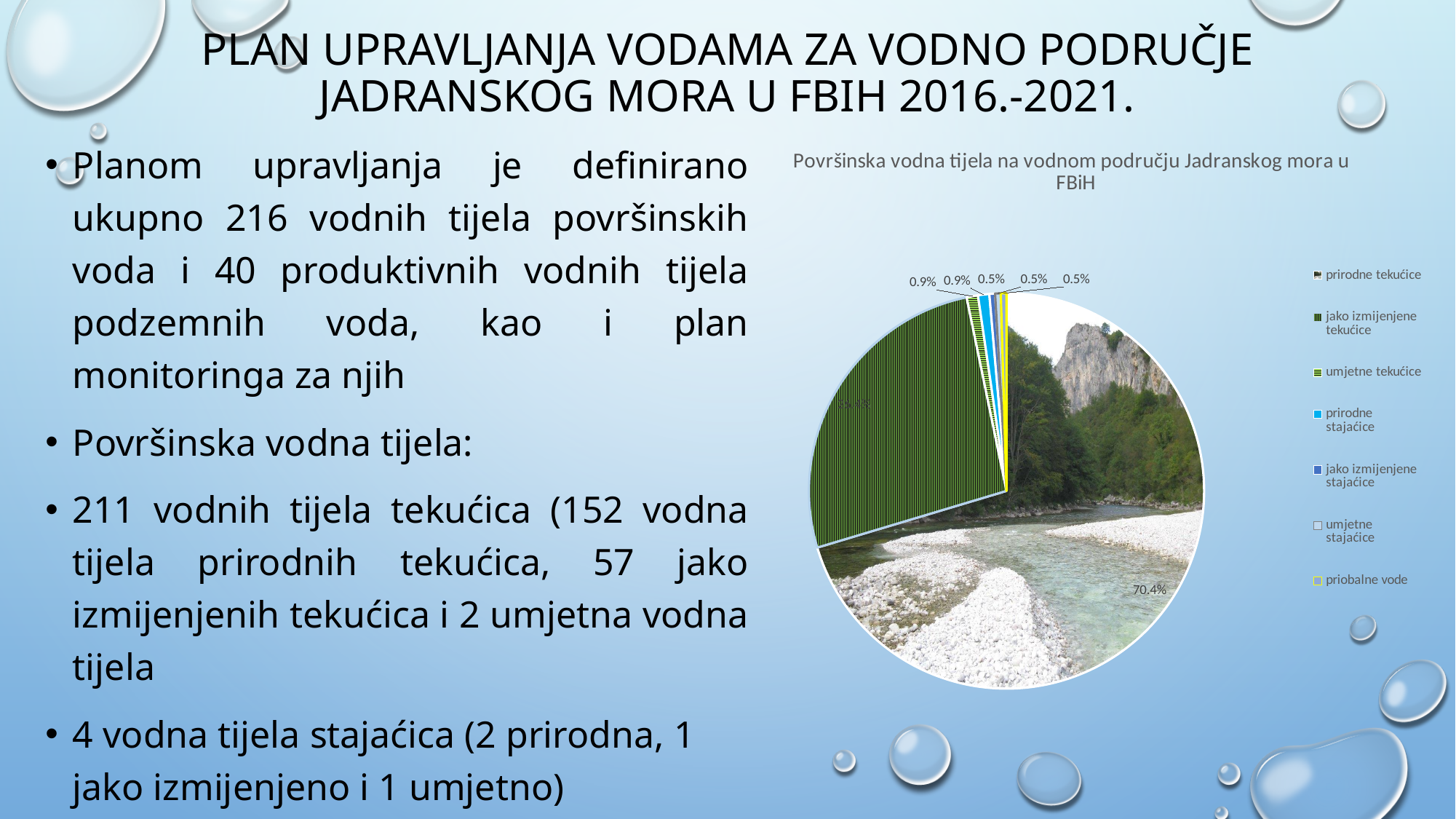
What percentage is shown for umjetne tekućice? 0.9% What is the difference in percentage points between prirodne tekućice and priobalne vode? 69.9% What percentage is shown for prirodne stajaćice? 0.9% Which category has the largest slice of the pie? prirodne tekućice What percentage is shown for priobalne vode? 0.5% What is the title of the chart? Površinska vodna tijela na vodnom području Jadranskog mora u FBiH What share of the pie is labelled for prirodne tekućice? 70.4% How many entries does the chart's legend list? 7 Which is larger, the slice for prirodne tekućice or the slice for jako izmijenjene tekućice? prirodne tekućice How many slices does the pie chart have? 7 What percentage is shown for umjetne stajaćice? 0.5% What kind of chart is shown on the slide? pie chart